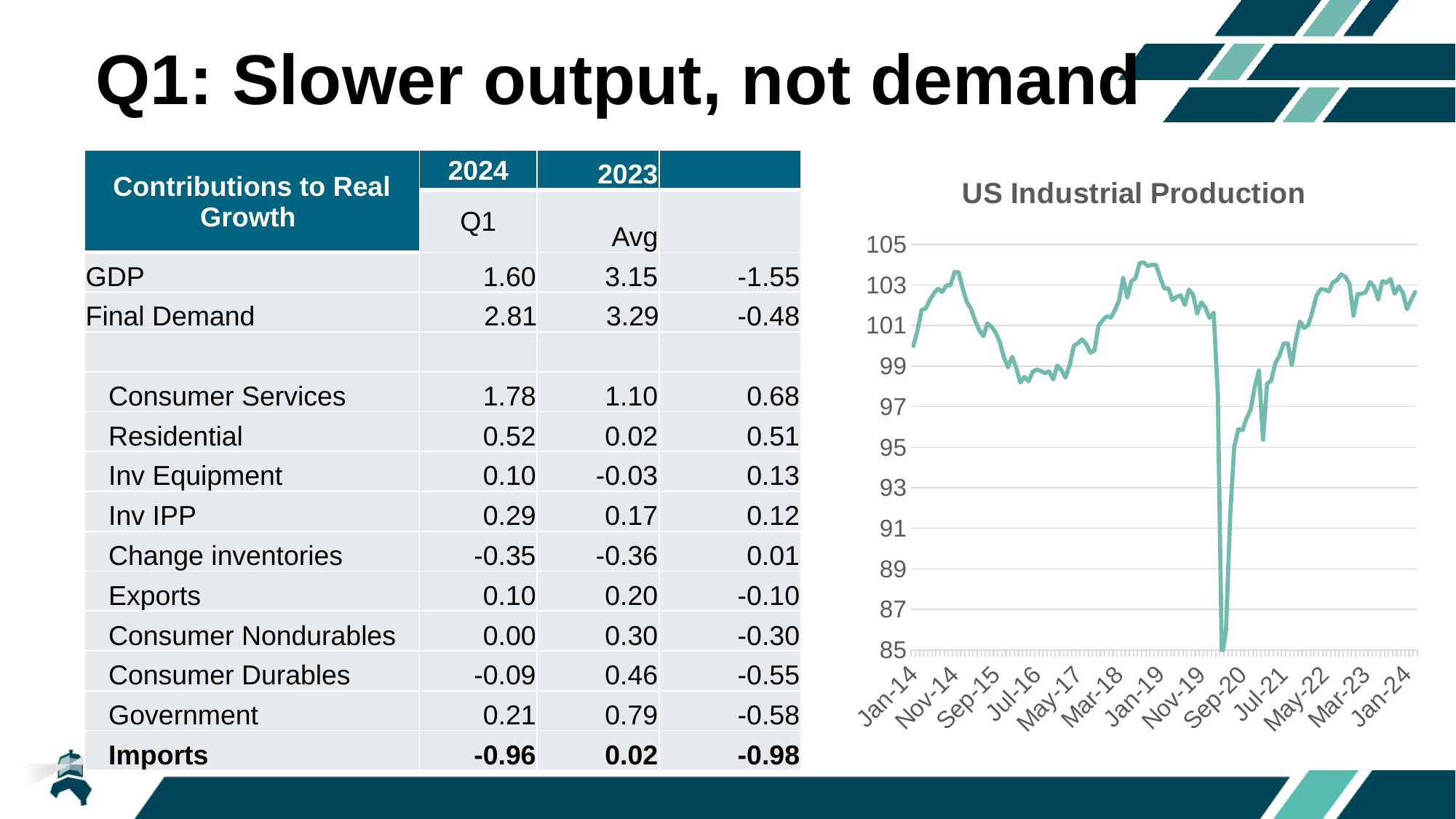
In the US Industrial Production chart, is the value at Jul-16 greater or less than 101? less In the US Industrial Production chart, is the value at Jan-24 greater or less than 101? greater What kind of chart is the US Industrial Production chart? line chart In the US Industrial Production chart, between which two x-axis labels does the sharp drop to the lowest point occur? Nov-19 and Sep-20 What is the title of the chart on the right side of the slide? US Industrial Production How many data series are plotted in the US Industrial Production chart? 1 In the US Industrial Production chart, does the line rise or fall between Jan-19 and Nov-19? fall What is the highest value shown on the y-axis of the US Industrial Production chart? 105 In the US Industrial Production chart, does the line rise or fall between Jan-14 and Nov-14? rise In the US Industrial Production chart, is the value at Jan-14 greater or less than 99? greater How many date labels are shown on the x-axis of the US Industrial Production chart? 13